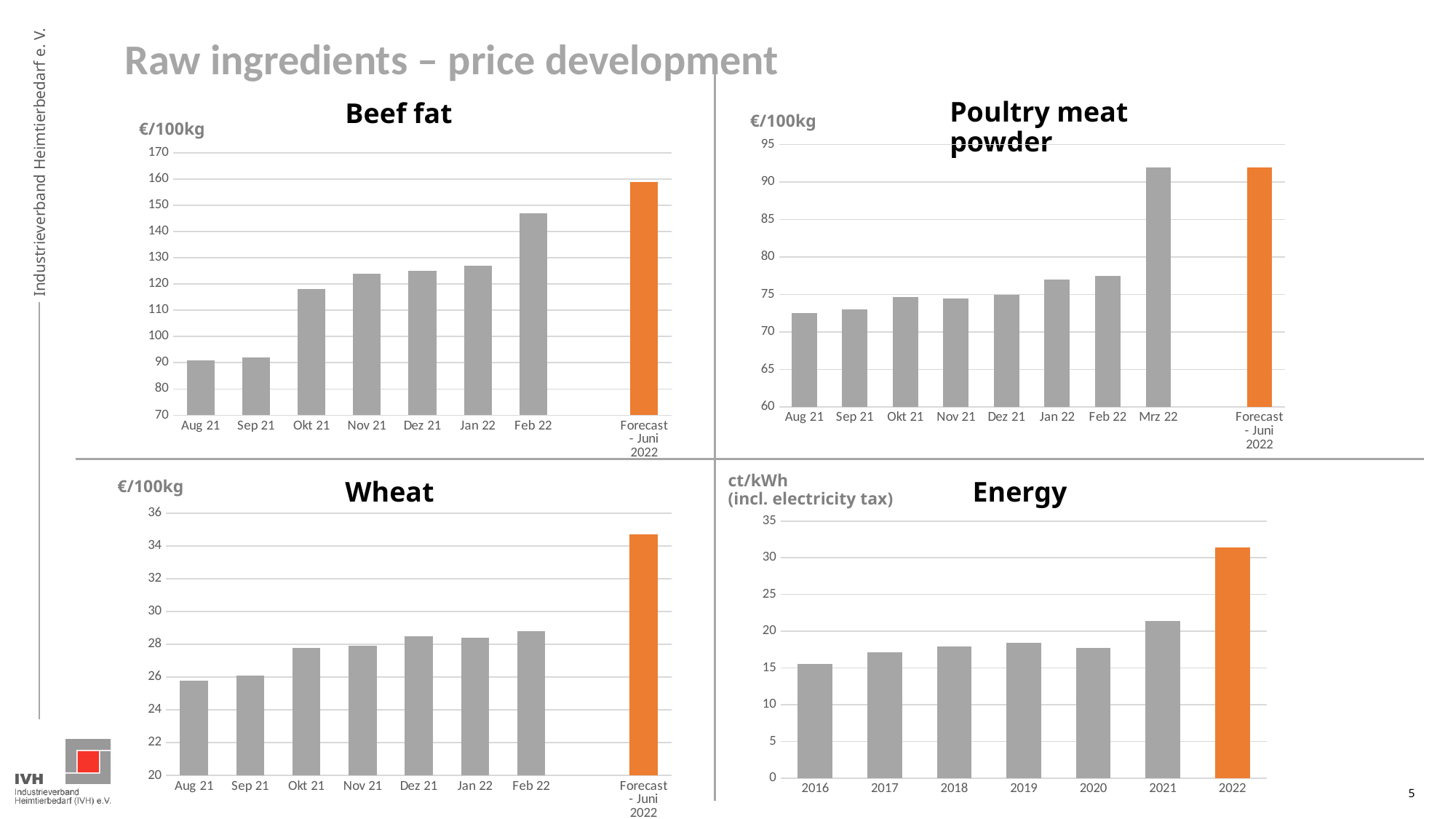
How many bars are plotted in the Beef fat chart? 8 In the Beef fat chart, is the value for Okt 21 greater or less than 120? less What unit is shown on the axis of the Energy chart? ct/kWh (incl. electricity tax) In the Poultry meat powder chart, which category has the lowest value? Aug 21 In the Wheat chart, which is larger, the value for Okt 21 or the value for Aug 21? Okt 21 In the Beef fat chart, is the value for Feb 22 greater or less than 140? greater How many bars are plotted in the Poultry meat powder chart? 9 In the Beef fat chart, which category has the highest value? Forecast - Juni 2022 In the Energy chart, which year has the lowest value? 2016 In the Wheat chart, is the value for Feb 22 greater or less than 30? less